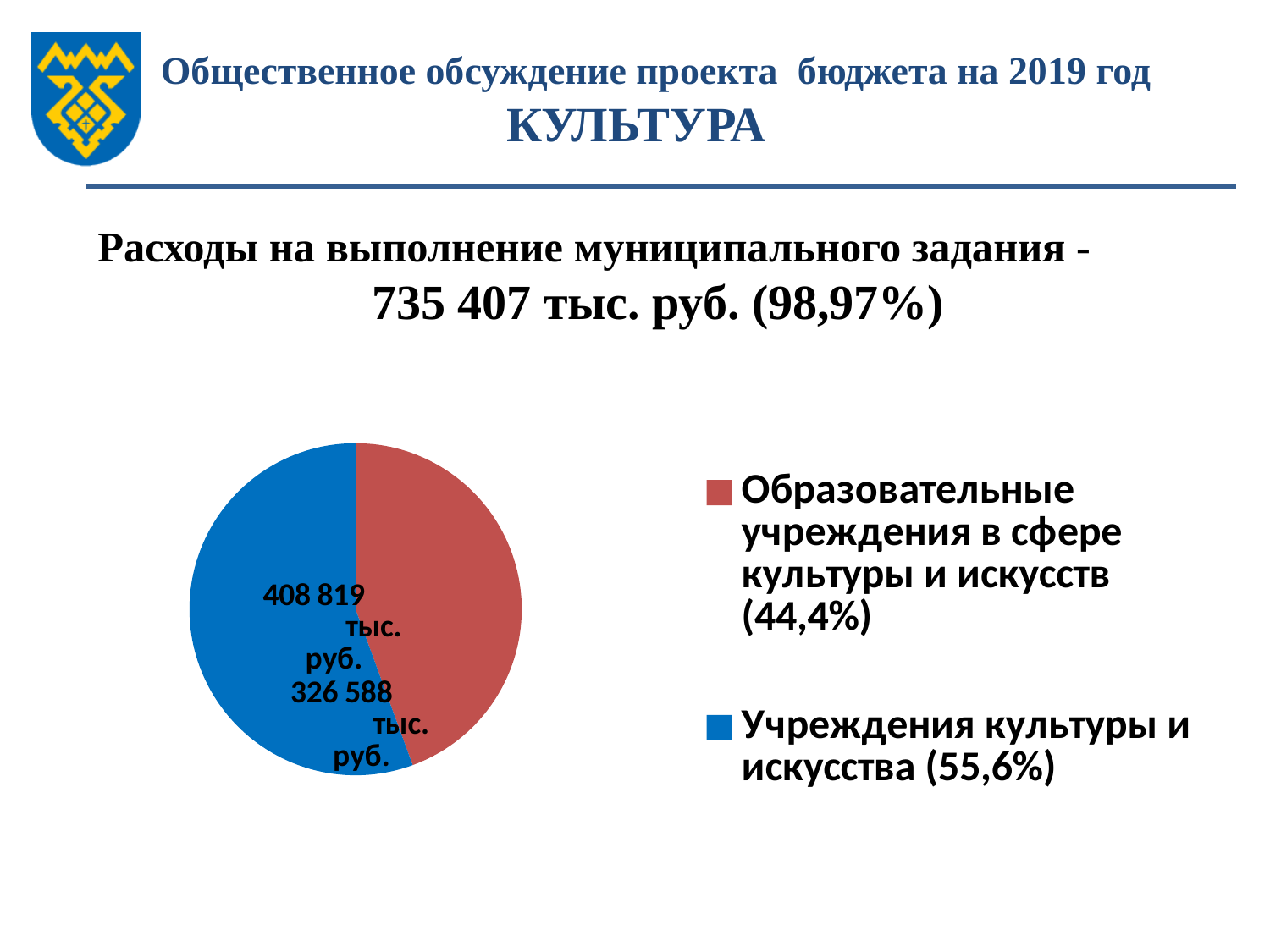
How many slices does the pie chart have? 2 What is the difference between the two values shown on the pie chart, 408 819 and 326 588 тыс. руб.? 82 231 тыс. руб. What kind of chart is shown on the slide? pie chart Which slice of the pie chart is the largest? Учреждения культуры и искусства What is the value shown for "Учреждения культуры и искусства" (55,6%)? 408 819 тыс. руб. What colour is the slice for "Учреждения культуры и искусства" in the pie chart? blue Which is larger: the slice for "Учреждения культуры и искусства" or the slice for "Образовательные учреждения в сфере культуры и искусств"? Учреждения культуры и искусства Which slice of the pie chart is the smallest? Образовательные учреждения в сфере культуры и искусств What is the value shown for "Образовательные учреждения в сфере культуры и искусств" (44,4%)? 326 588 тыс. руб. How many entries does the legend of the pie chart list? 2 What share of the pie does "Учреждения культуры и искусства" take? 55,6% What share of the pie does "Образовательные учреждения в сфере культуры и искусств" take? 44,4%